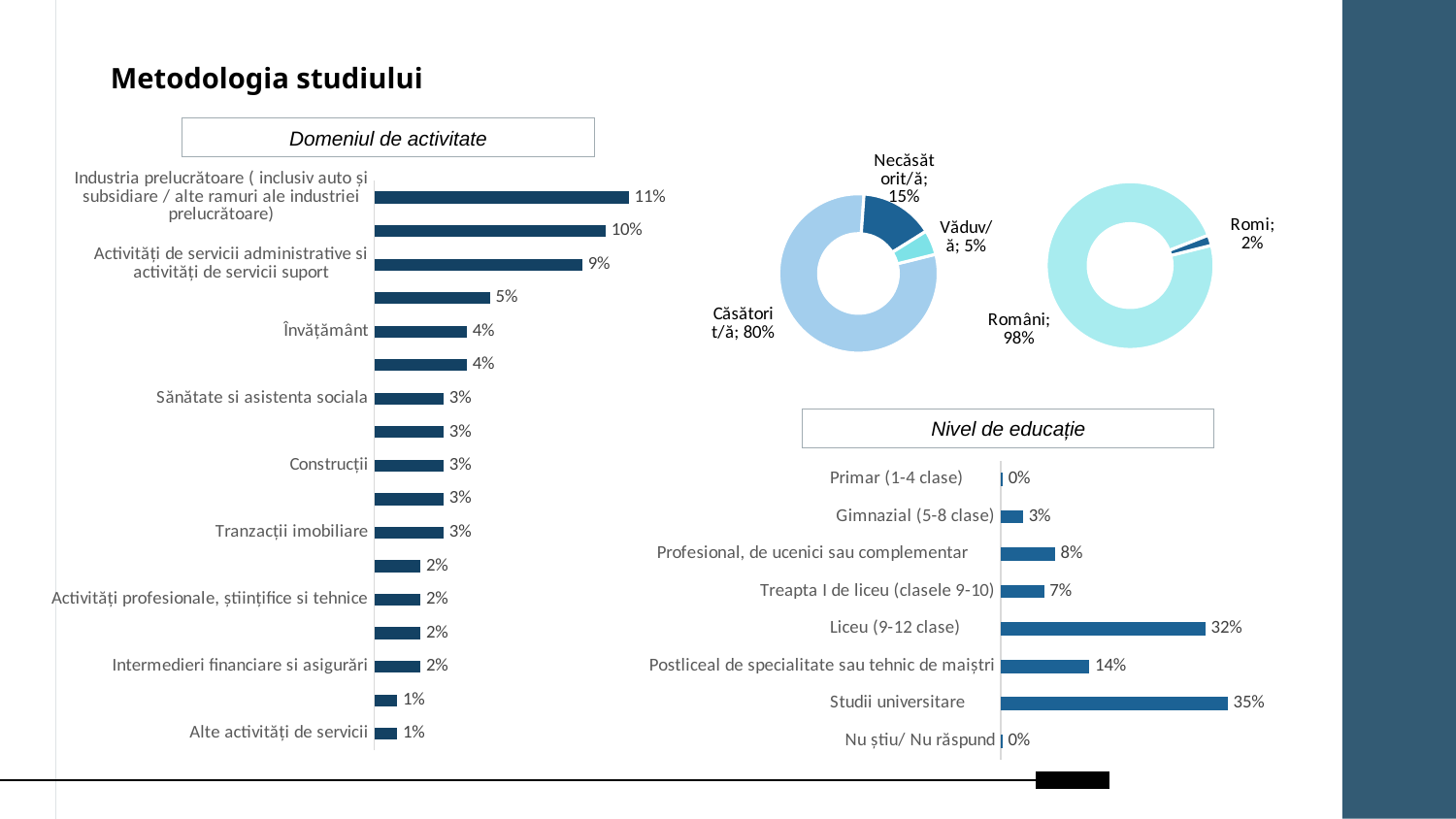
How many categories does the 'Nivel de educație' chart show? 8 What kind of chart is the 'Domeniul de activitate' chart? Bar chart In the 'Nivel de educație' chart, what is the difference between Studii universitare and Postliceal de specialitate sau tehnic de maiștri? 21% In the 'Domeniul de activitate' chart, what is the value for Activități de servicii administrative si activități de servicii suport? 9% In the 'Domeniul de activitate' chart, what is the value for Industria prelucrătoare? 11% In the 'Domeniul de activitate' chart, what is the difference between Industria prelucrătoare and Intermedieri financiare si asigurări? 9% In the 'Nivel de educație' chart, which is larger: Profesional, de ucenici sau complementar or Treapta I de liceu (clasele 9-10)? Profesional, de ucenici sau complementar In the ethnicity donut chart (top right), what is the share for Romi? 2% In the marital status donut chart (top middle), what is the share for Căsătorit/ă? 80% In the 'Nivel de educație' chart, which category has the highest value? Studii universitare In the 'Domeniul de activitate' chart, what is the value for Învățământ? 4% In the 'Nivel de educație' chart, what is the value for Liceu (9-12 clase)? 32%